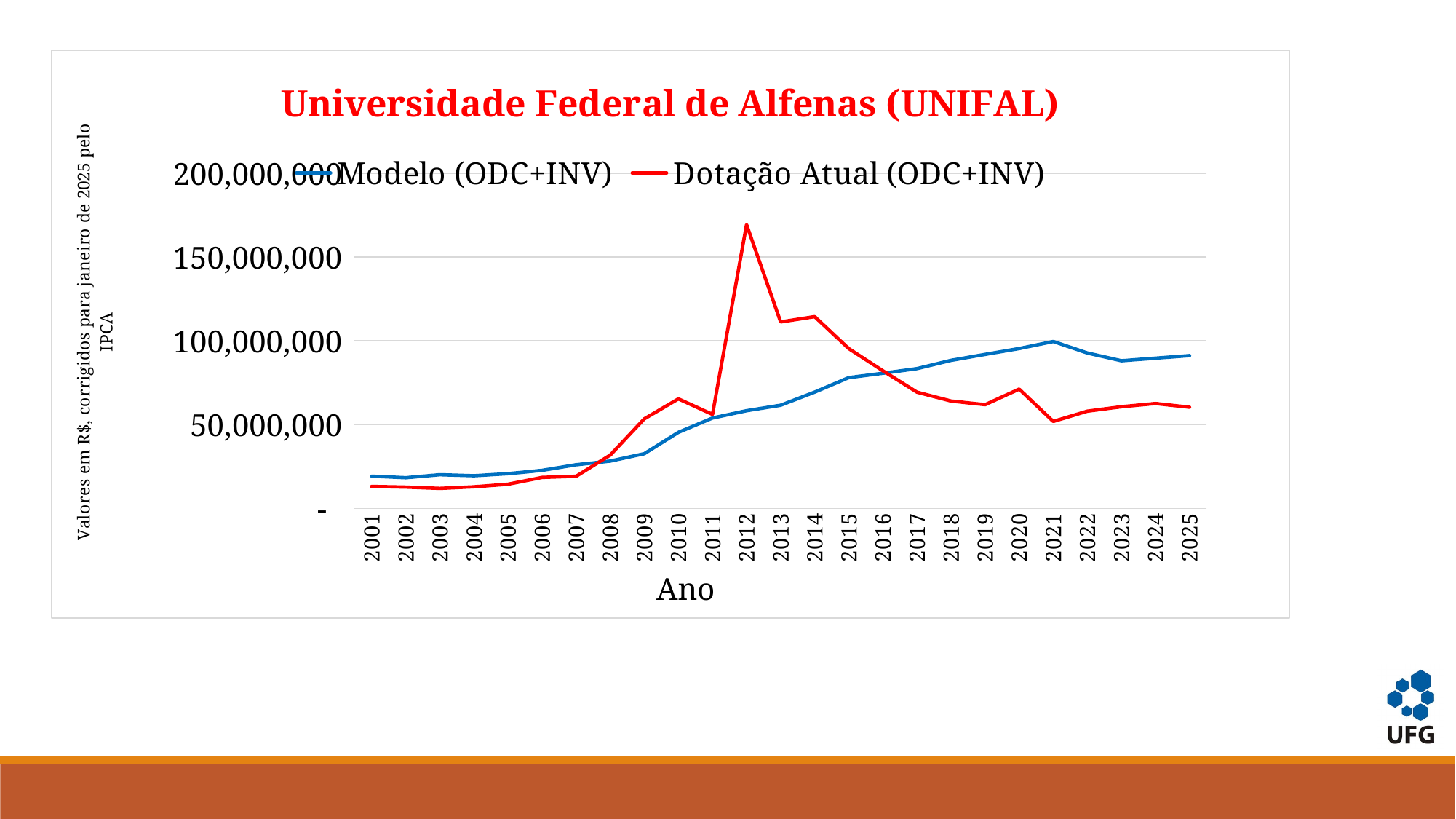
In which year does the Modelo (ODC+INV) series reach its highest value? 2021 In 2025, which series has the larger value, Modelo (ODC+INV) or Dotação Atual (ODC+INV)? Modelo (ODC+INV) What is the title of the chart? Universidade Federal de Alfenas (UNIFAL) How many years are plotted along the x axis? 25 In 2013, which series has the larger value, Modelo (ODC+INV) or Dotação Atual (ODC+INV)? Dotação Atual (ODC+INV) How many series does the legend list? 2 Does the Modelo (ODC+INV) series generally rise or fall from 2001 to 2021? rise In which year does the Dotação Atual (ODC+INV) series reach its highest value? 2012 Is the value of Dotação Atual (ODC+INV) in 2012 greater or less than 150,000,000? greater Is the value of Modelo (ODC+INV) in 2025 greater or less than 100,000,000? less What kind of chart is shown on the slide? line chart Is the value of Dotação Atual (ODC+INV) in 2021 greater or less than 100,000,000? less